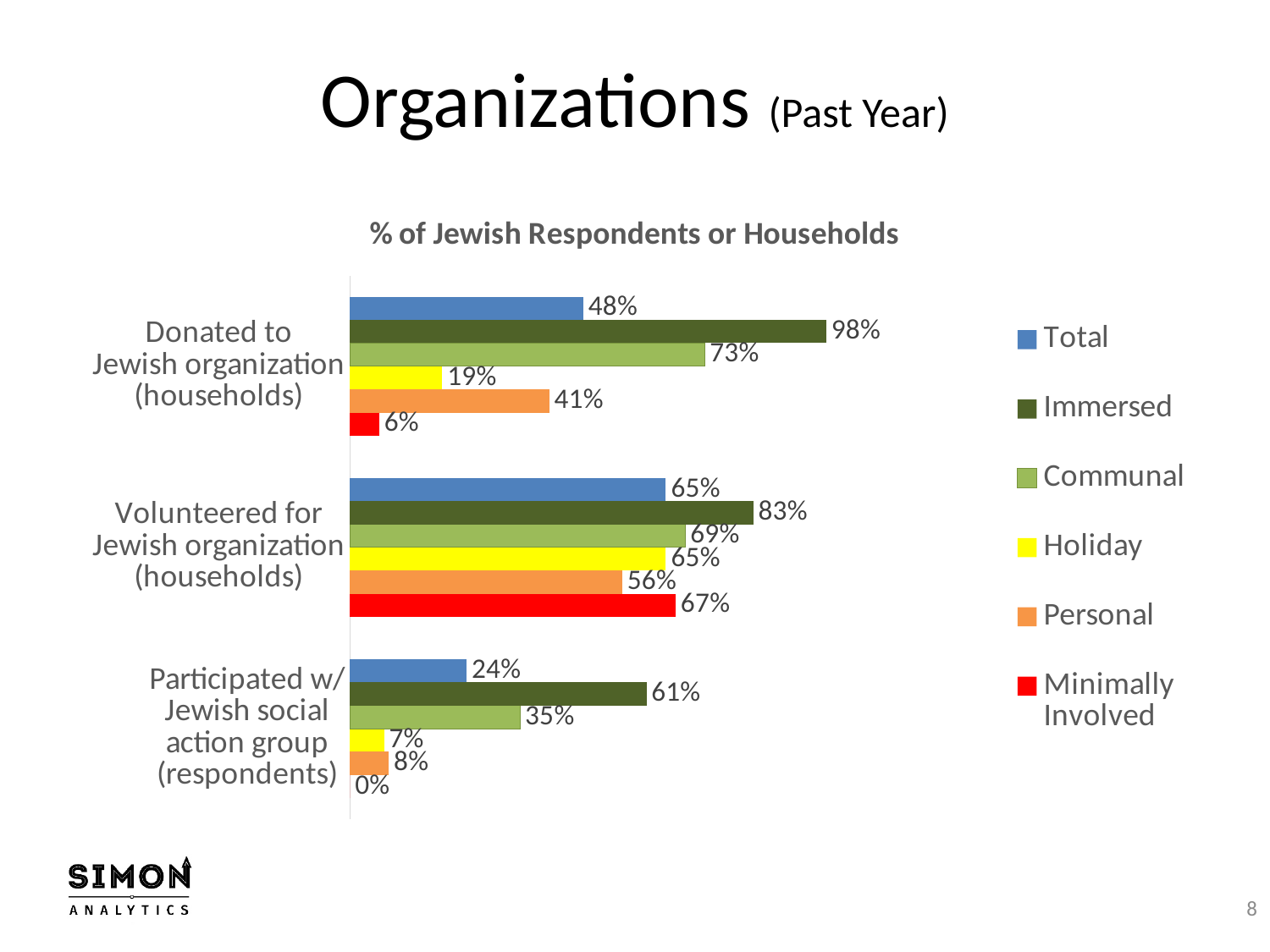
Which series has the highest value for Volunteered for Jewish organization (households)? Immersed What is the title of the chart? % of Jewish Respondents or Households What kind of chart is shown on the slide? Bar chart What is the Minimally Involved value for Participated w/ Jewish social action group (respondents)? 0% What is the Personal value for Donated to Jewish organization (households)? 41% How many series does the legend list? 6 What is the difference between the Immersed and Communal values for Donated to Jewish organization (households)? 25% How many categories are shown on the chart? 3 What is the Immersed value for Donated to Jewish organization (households)? 98% Which is larger for Participated w/ Jewish social action group (respondents): the Total value or the Communal value? Communal What is the Total value for Volunteered for Jewish organization (households)? 65% Which series has the lowest value for Donated to Jewish organization (households)? Minimally Involved